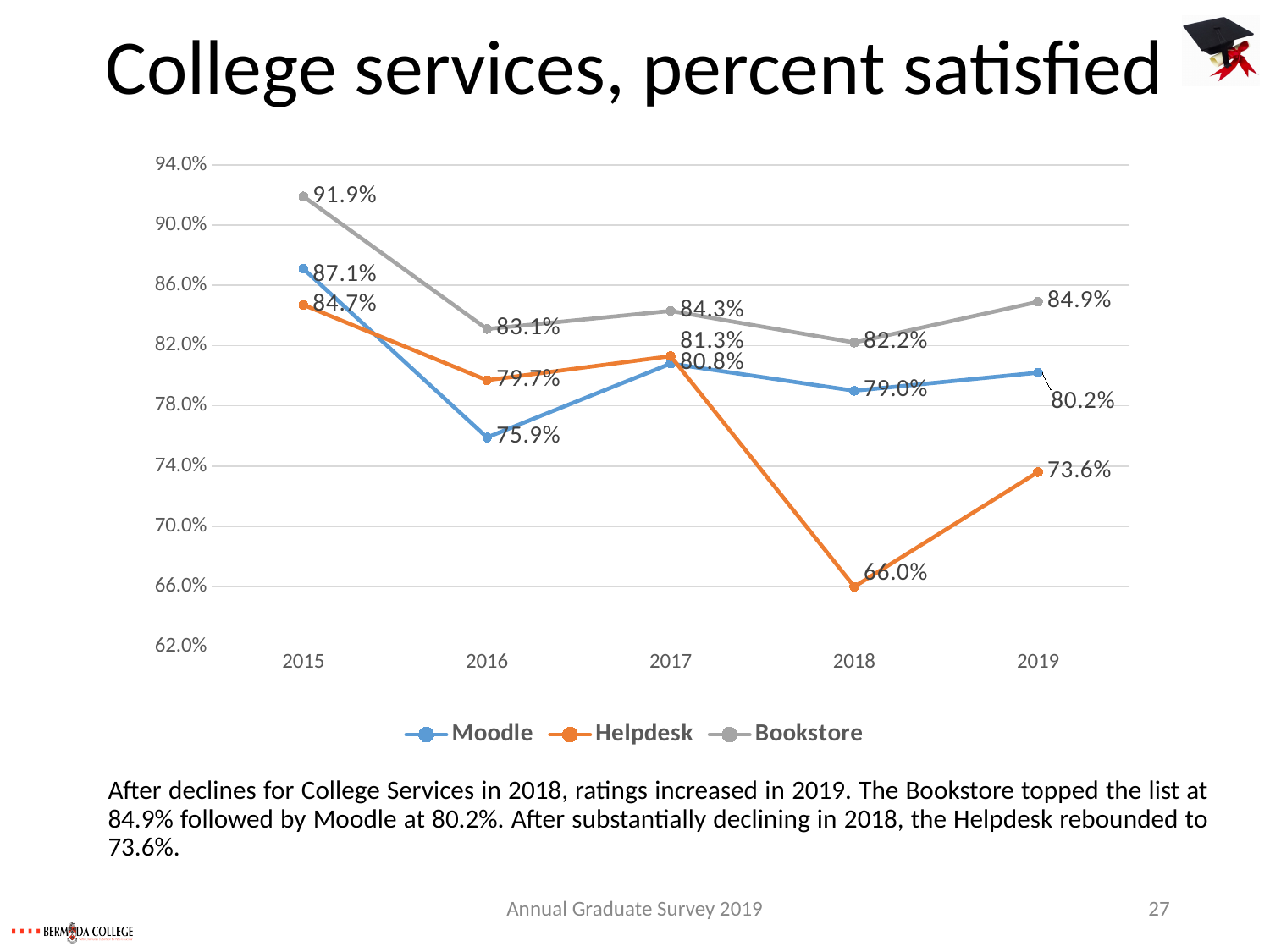
Which series had the highest percent satisfied in 2019? Bookstore What was the Helpdesk's percent satisfied in 2018? 66.0% How many years are shown on the x axis? 5 In which year was the Helpdesk's percent satisfied lowest? 2018 What was Moodle's percent satisfied in 2016? 75.9% Which was higher in 2017, Moodle or Helpdesk? Helpdesk How many series does the legend list? 3 What type of chart is shown on the slide? line chart Did the Bookstore's percent satisfied rise or fall from 2015 to 2016? fall What was the Bookstore's percent satisfied in 2015? 91.9% What is the difference between the Bookstore's and Moodle's percent satisfied in 2019? 4.7% What colour is the line for the Helpdesk series? orange